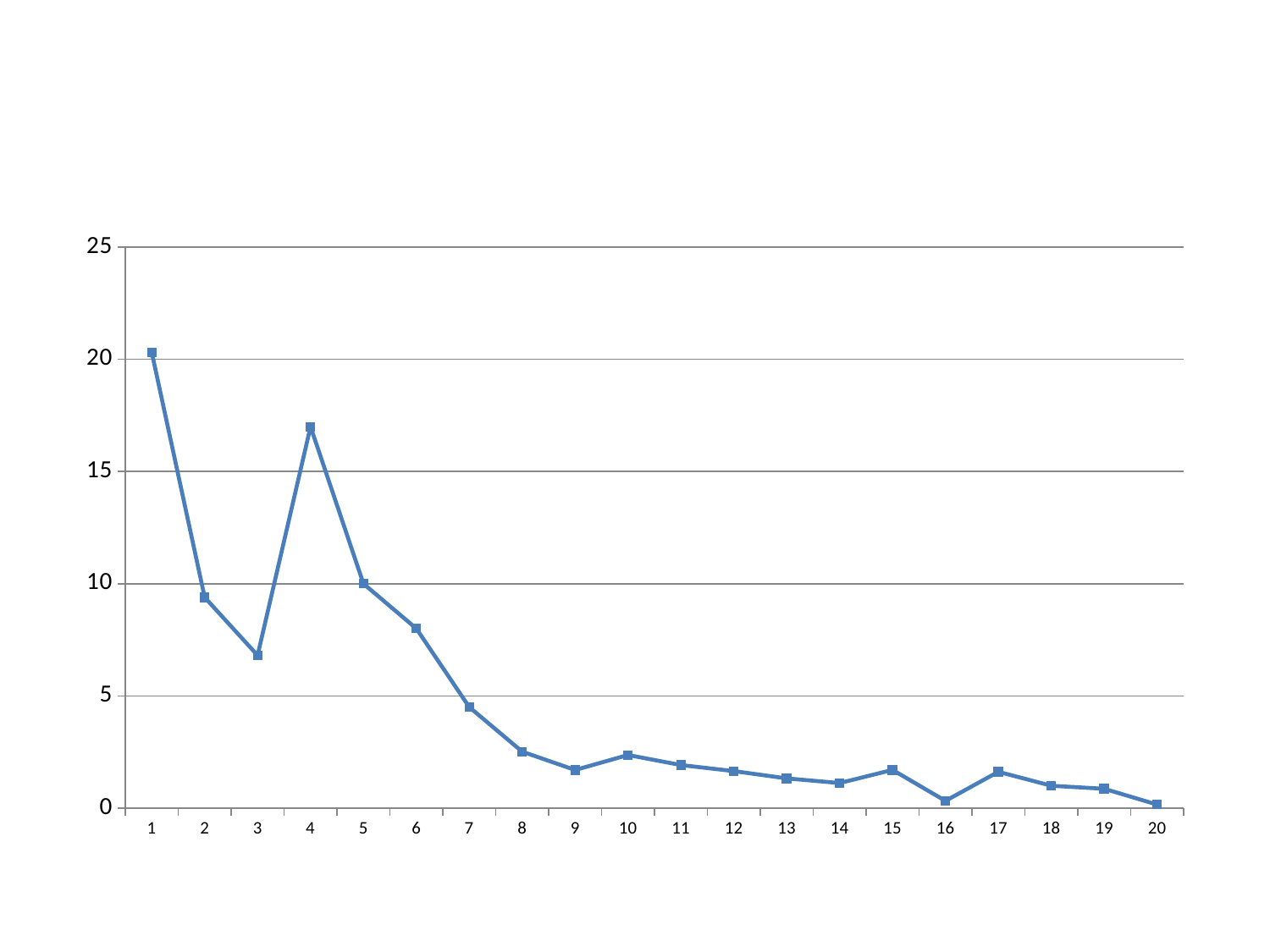
Is the value at x = 2 greater or less than 10? less Do the values generally rise or fall from x = 1 to x = 20? fall Which is larger, the value at x = 2 or the value at x = 3? x = 2 How many data points are plotted on the line? 20 What kind of chart is shown on the slide? line chart Which x-axis category has the highest value? 1 Which is larger, the value at x = 9 or the value at x = 10? x = 10 Is the value at x = 4 greater or less than 15? greater Is the value at x = 6 greater or less than 10? less Which is larger, the value at x = 1 or the value at x = 4? x = 1